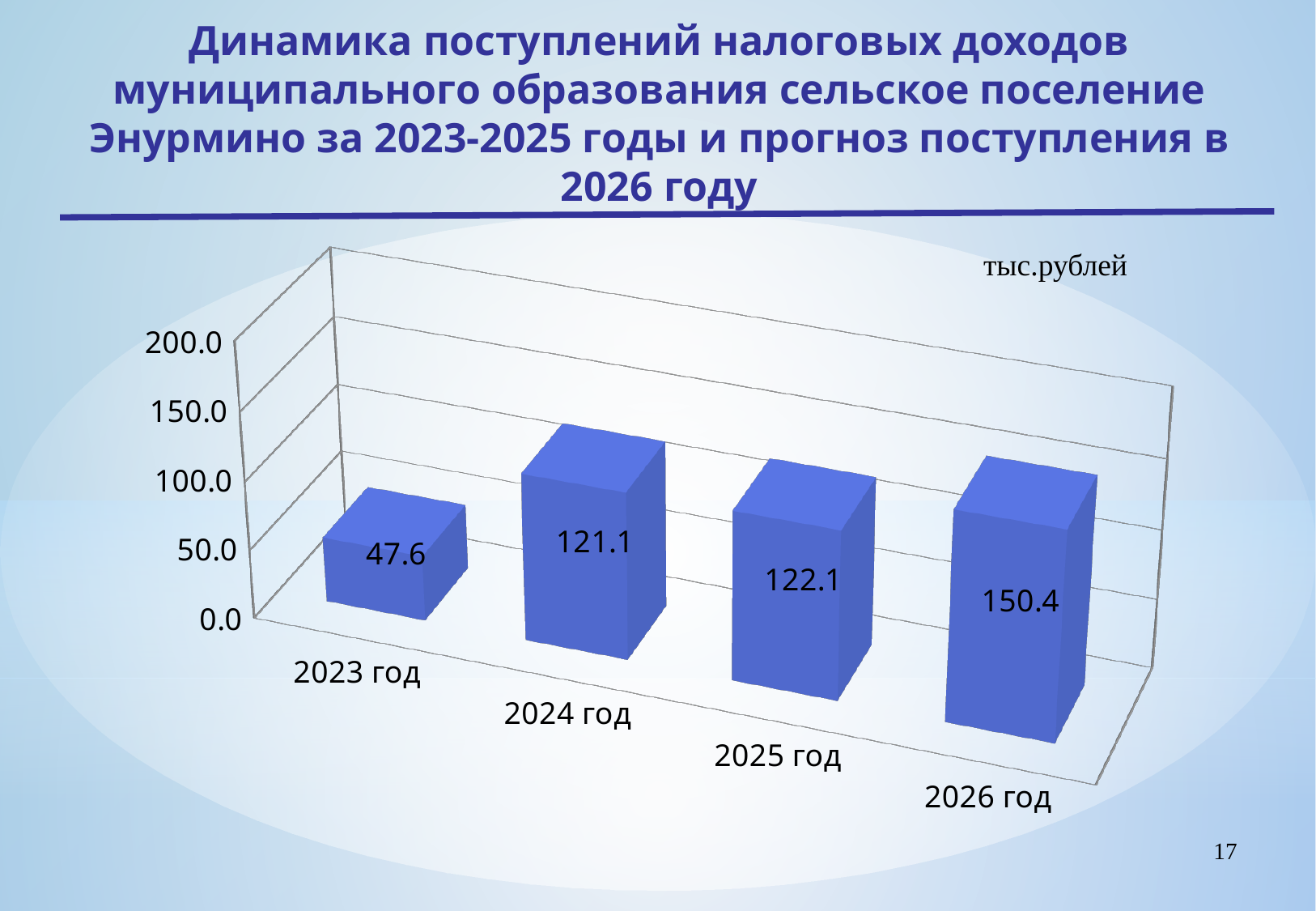
What is the value for 2023 год? 47.6 Which year has the lowest value? 2023 год Which is larger, the value for 2024 год or the value for 2026 год? 2026 год What is the difference between the values for 2026 год and 2023 год? 102.8 What is the value for 2024 год? 121.1 How many years are shown on the chart? 4 What unit of measurement is indicated on the chart? тыс.рублей What is the difference between the values for 2025 год and 2024 год? 1.0 Which year has the highest value? 2026 год What is the forecast value for 2026 год? 150.4 What kind of chart is shown on the slide? bar chart What is the value for 2025 год? 122.1